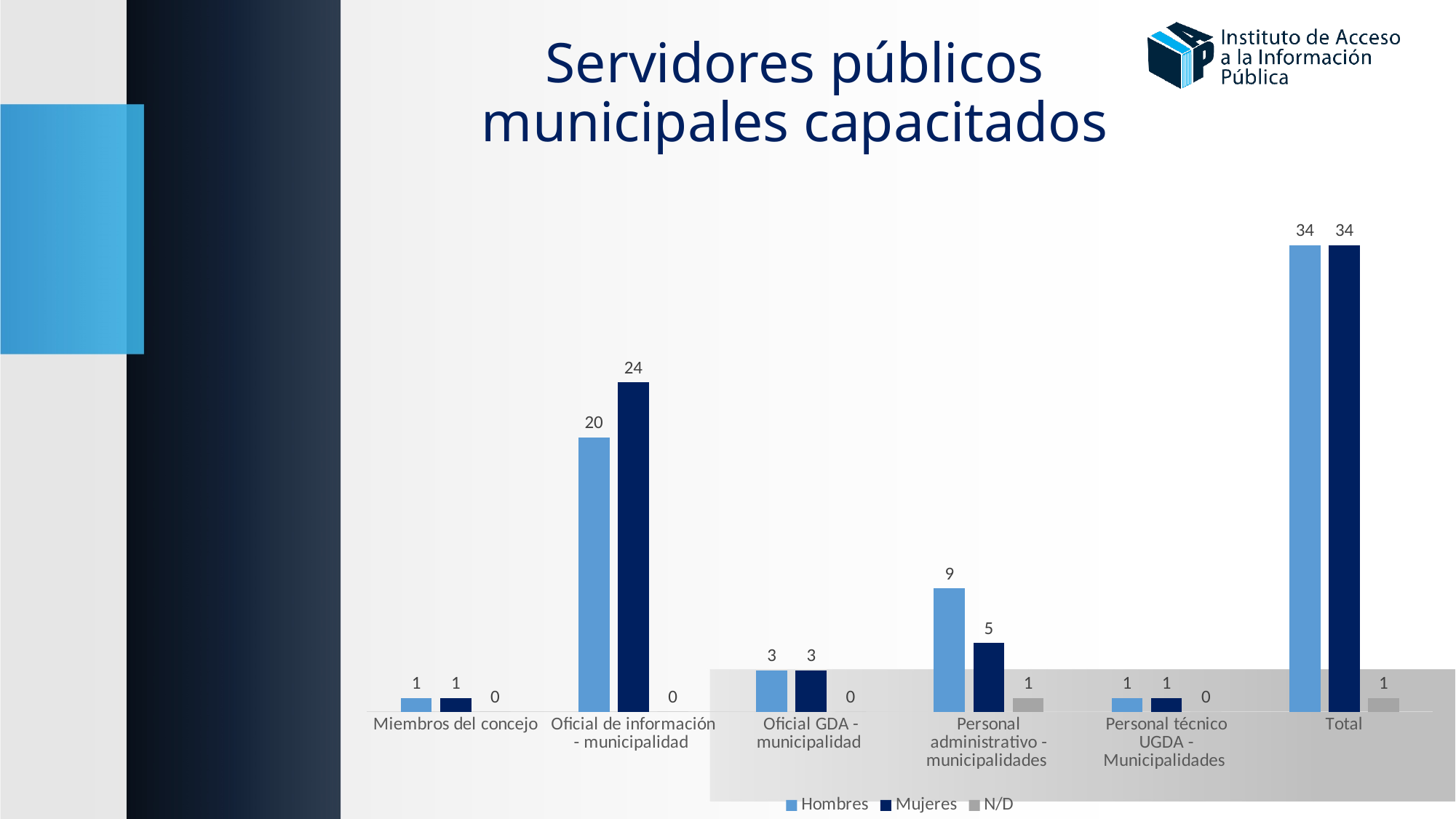
What is the title of the chart? Servidores públicos municipales capacitados What is the difference between the Mujeres and Hombres values in the 'Oficial de información - municipalidad' category? 4 Which series is shown in grey in the legend? N/D How many categories are shown on the x axis? 6 In the 'Personal administrativo - municipalidades' category, which is larger, Hombres or Mujeres? Hombres What is the N/D value for the 'Total' category? 1 What is the value for Hombres in the 'Total' category? 34 What is the value for Mujeres in the 'Personal administrativo - municipalidades' category? 5 What kind of chart is shown on the slide? Bar chart How many series does the legend list? 3 Excluding the Total category, which category has the highest Mujeres value? Oficial de información - municipalidad What is the value for Hombres in the 'Oficial de información - municipalidad' category? 20